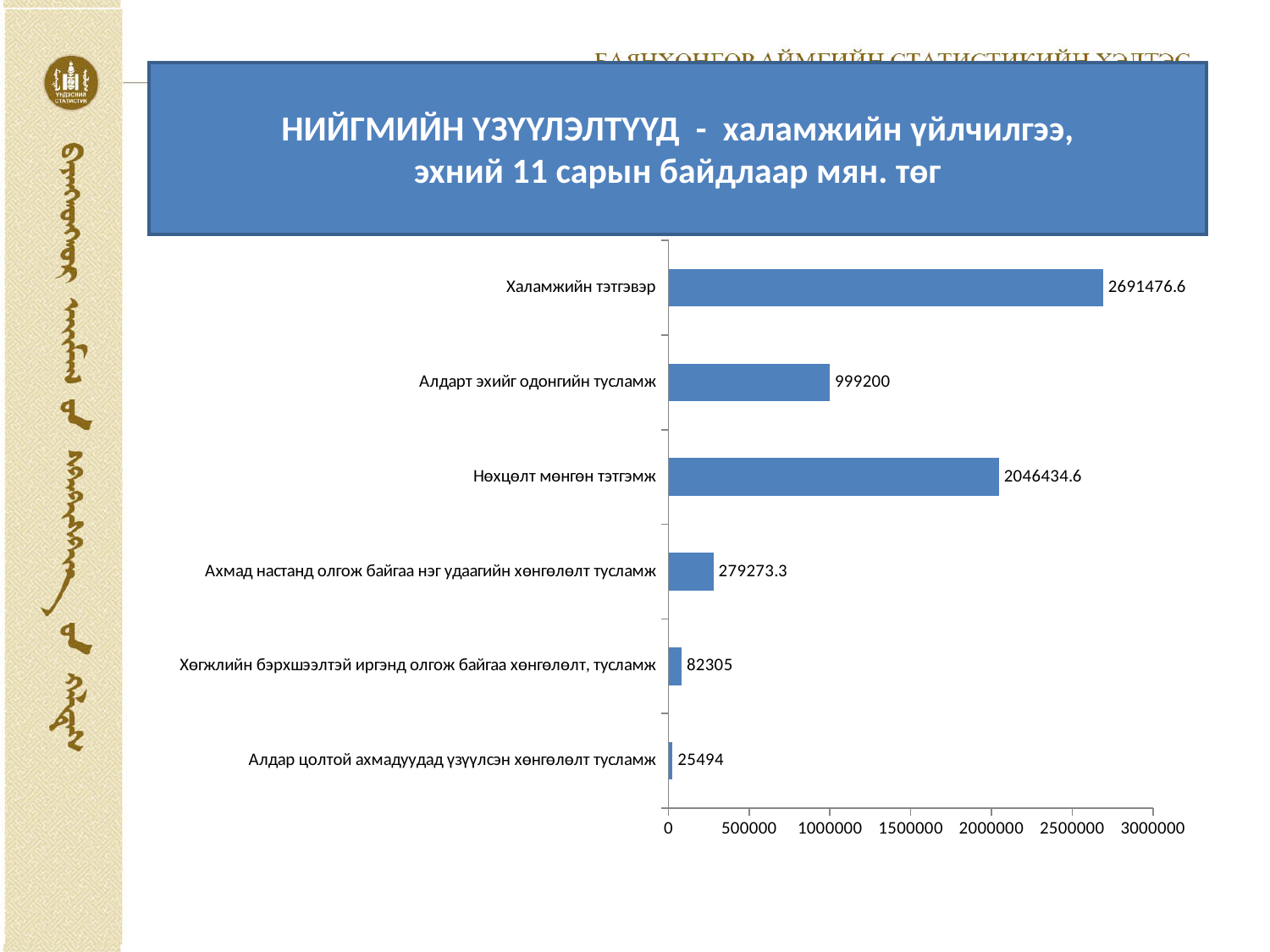
What is the difference between Хөгжлийн бэрхшээлтэй иргэнд олгож байгаа хөнгөлөлт, тусламж and Алдар цолтой ахмадуудад үзүүлсэн хөнгөлөлт тусламж? 56811 What is the value for Нөхцөлт мөнгөн тэтгэмж? 2046434.6 How many categories are shown in the chart? 6 What kind of chart is shown on the slide? bar chart What is the value for Халамжийн тэтгэвэр? 2691476.6 Which is larger: Алдарт эхийг одонгийн тусламж or Ахмад настанд олгож байгаа нэг удаагийн хөнгөлөлт тусламж? Алдарт эхийг одонгийн тусламж What is the value for Алдарт эхийг одонгийн тусламж? 999200 What is the value for Хөгжлийн бэрхшээлтэй иргэнд олгож байгаа хөнгөлөлт, тусламж? 82305 Which category has the highest value? Халамжийн тэтгэвэр Which category has the lowest value? Алдар цолтой ахмадуудад үзүүлсэн хөнгөлөлт тусламж Is the value for Нөхцөлт мөнгөн тэтгэмж greater or less than 2000000? greater What is the difference between Халамжийн тэтгэвэр and Нөхцөлт мөнгөн тэтгэмж? 645042